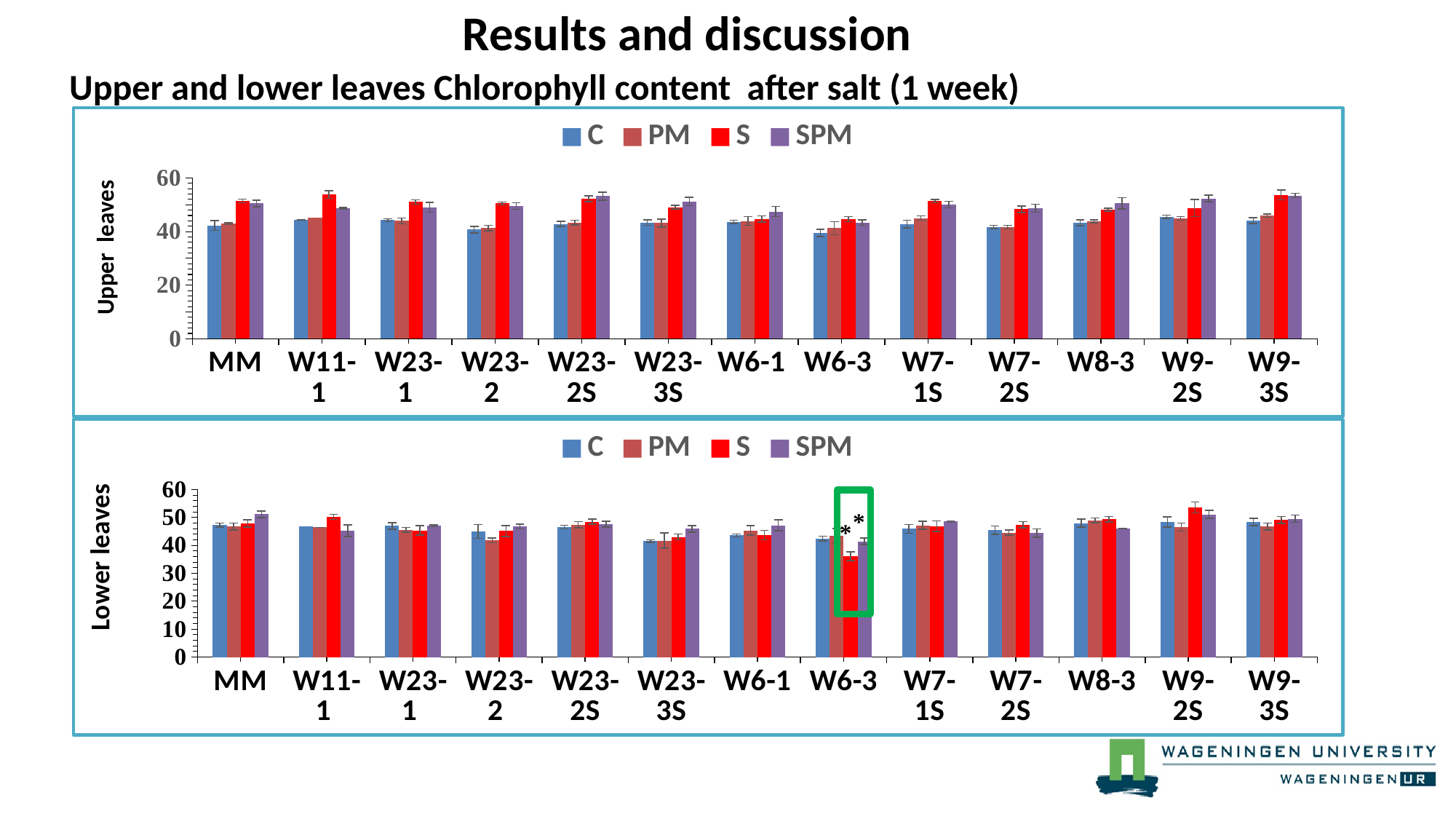
In the Lower leaves chart, which category is highlighted with a green rectangle? W6-3 In the Lower leaves chart, is the S value for W6-3 greater or less than 40? less What kind of chart is the Upper leaves chart? bar chart In the Upper leaves chart, is the S value for W11-1 greater or less than 40? greater In the Upper leaves chart, is the C value for W23-2 greater or less than 20? greater How many series does the legend of the Lower leaves chart list? 4 In the Upper leaves chart, what colour represents the S series? red In the Lower leaves chart, which is larger for W6-3: the C value or the S value? C In the Upper leaves chart, which is larger for W11-1: the C value or the S value? S How many categories are shown on the x axis of the Upper leaves chart? 13 In the Lower leaves chart, which category has the lowest S value? W6-3